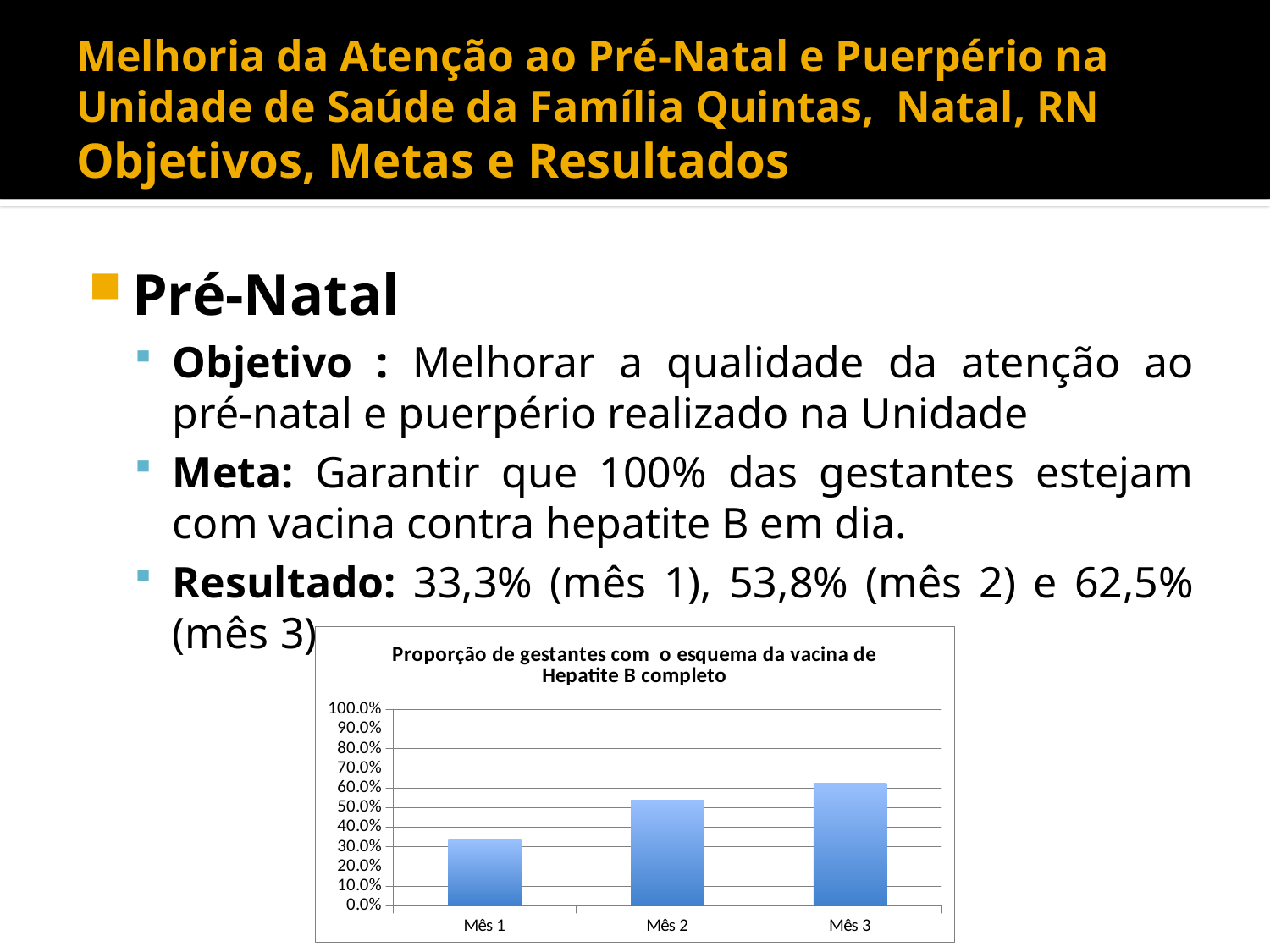
According to the slide, what is the proportion of pregnant women with the complete Hepatitis B vaccine scheme in mês 1? 33,3% Do the values rise or fall from Mês 1 to Mês 3? rise What is the title of the chart? Proporção de gestantes com o esquema da vacina de Hepatite B completo Is the value for Mês 1 greater or less than 40.0%? less Which is larger, the value for Mês 2 or the value for Mês 3? Mês 3 Is the value for Mês 2 greater or less than 50.0%? greater What kind of chart is shown on the slide? bar chart How many categories (months) are plotted in the chart? 3 Which month has the highest bar in the chart? Mês 3 According to the slide, what is the proportion of pregnant women with the complete Hepatitis B vaccine scheme in mês 3? 62,5% Is the value for Mês 3 greater or less than 70.0%? less Which month has the lowest bar in the chart? Mês 1